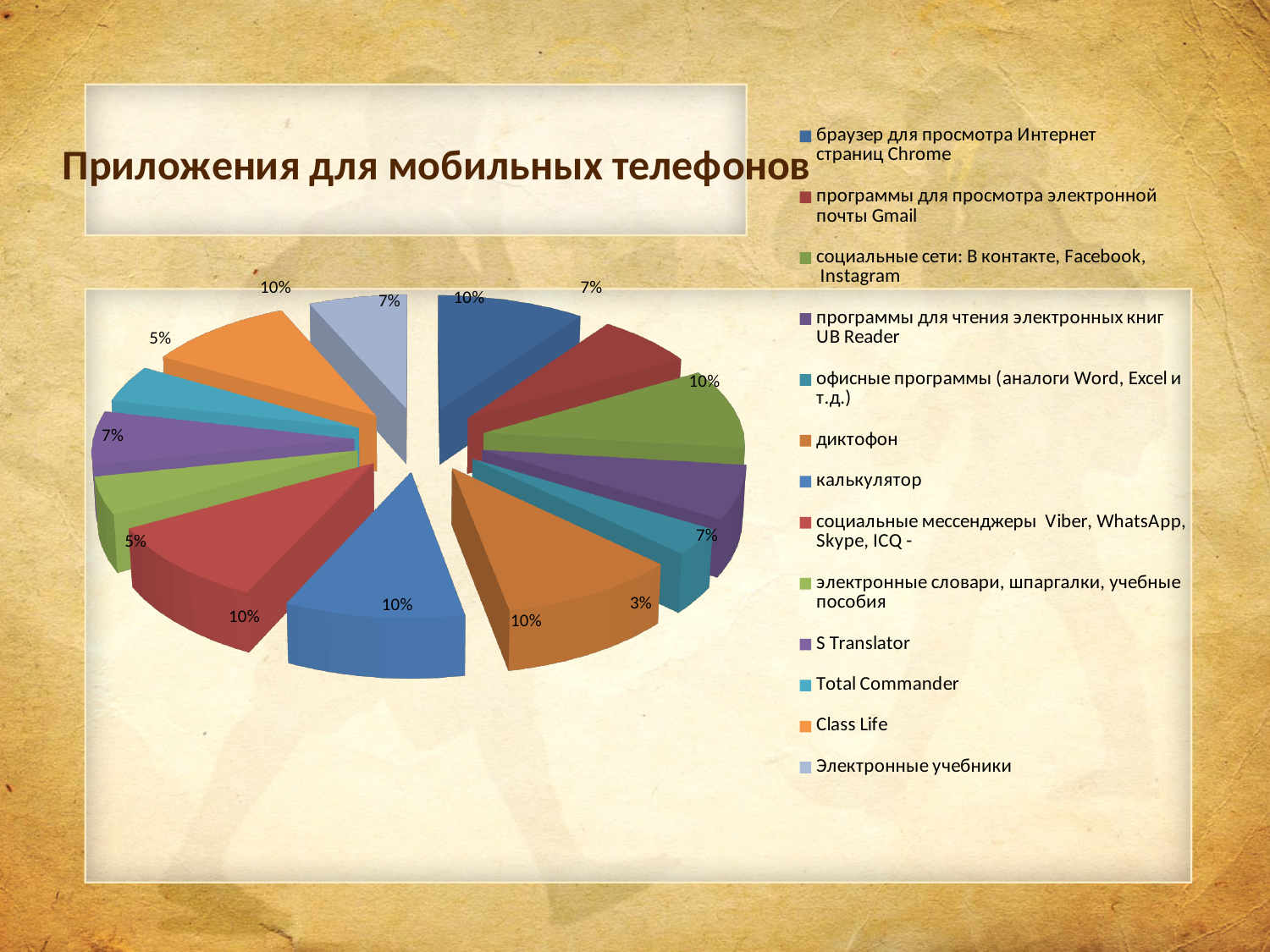
Which category has the smallest slice of the pie? офисные программы (аналоги Word, Excel и т.д.) What kind of chart is shown on the slide? pie chart Which slice is larger: 'калькулятор' or 'офисные программы (аналоги Word, Excel и т.д.)'? калькулятор What is the title of the chart? Приложения для мобильных телефонов What share of the pie is labelled for 'браузер для просмотра Интернет страниц Chrome'? 10% What share of the pie is labelled for 'Электронные учебники'? 7% How many entries does the chart legend list? 13 What colour is the slice for 'Электронные учебники' in the legend? light blue What is the difference between the share for 'браузер для просмотра Интернет страниц Chrome' and the share for 'офисные программы (аналоги Word, Excel и т.д.)'? 7% How many slices does the pie chart have? 13 What share of the pie is labelled for 'офисные программы (аналоги Word, Excel и т.д.)'? 3% What share of the pie is labelled for 'калькулятор'? 10%